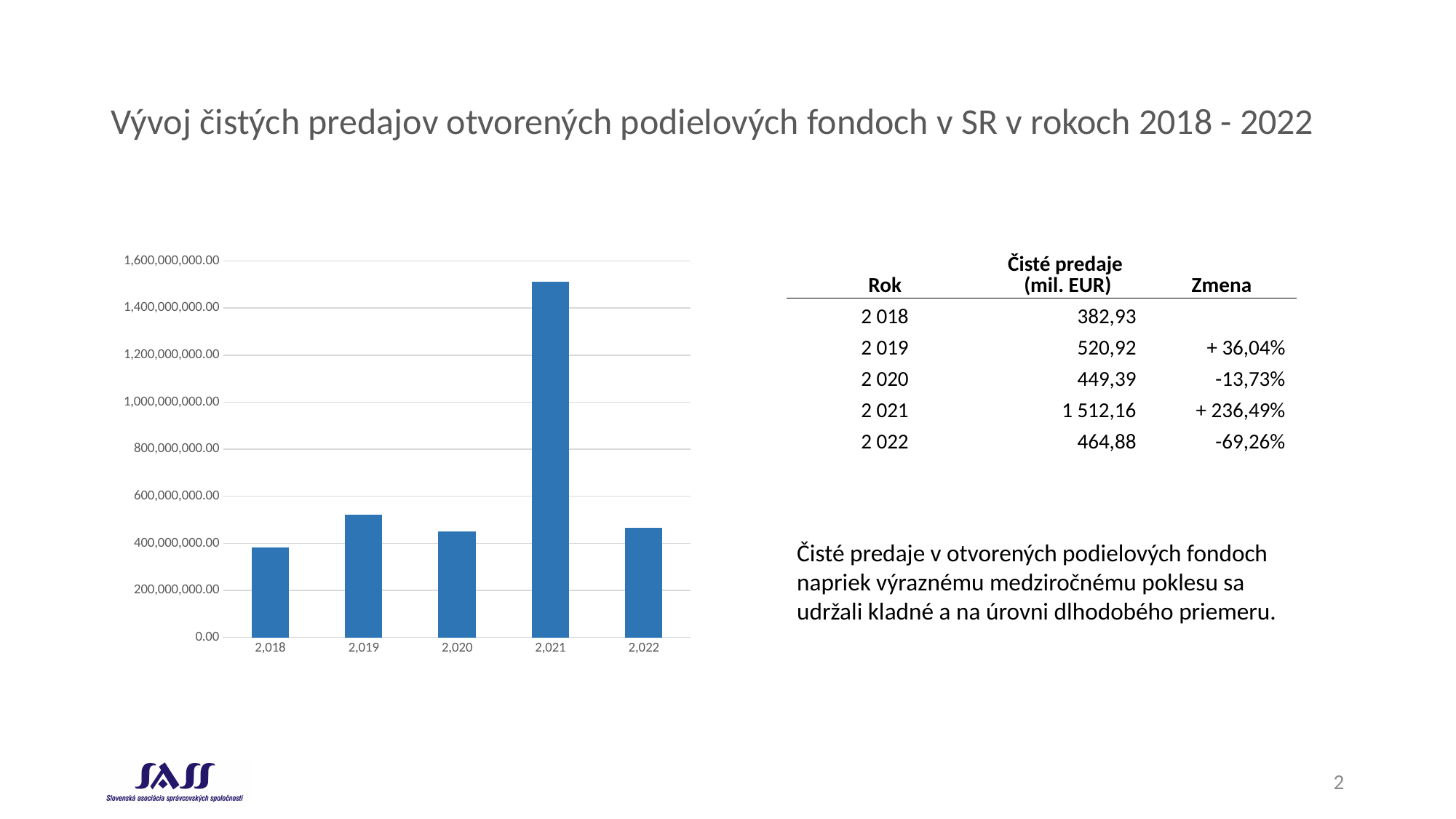
What is the title of the slide containing the chart? Vývoj čistých predajov otvorených podielových fondoch v SR v rokoch 2018 - 2022 How many years (bars) are plotted in the chart? 5 Which year has the highest bar in the chart? 2,021 Is the value for 2,018 in the chart greater or less than 600,000,000.00? less What kind of chart is shown on the slide? bar chart According to the table on the slide, what were the net sales (Čisté predaje, mil. EUR) in 2 021? 1 512,16 Is the value for 2,021 in the chart greater or less than 1,400,000,000.00? greater Which bar is taller in the chart, 2,019 or 2,020? 2,019 Does the chart value rise or fall from 2,021 to 2,022? fall Is the value for 2,020 in the chart greater or less than 400,000,000.00? greater Which year has the lowest bar in the chart? 2,018